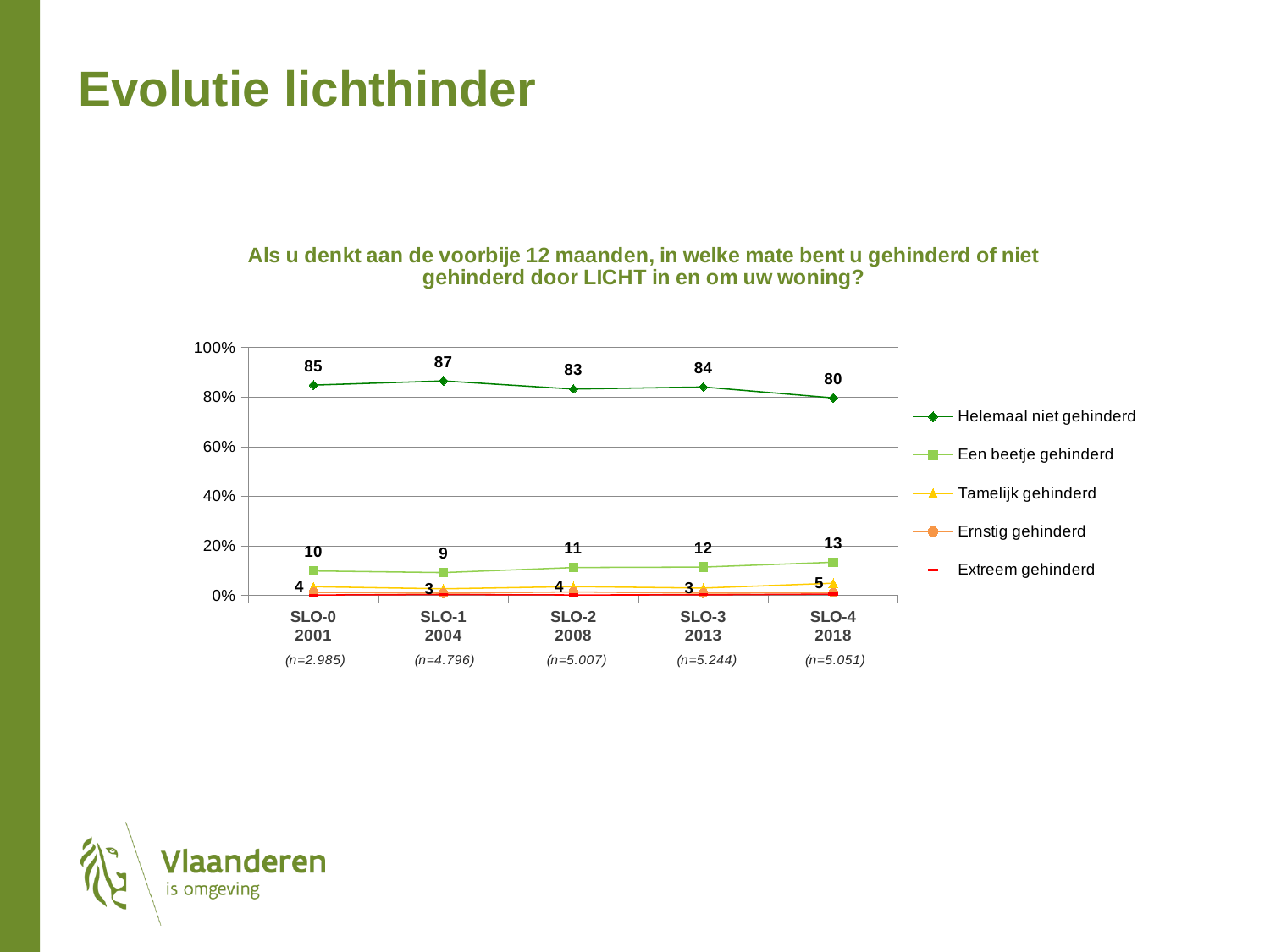
What kind of chart is shown on the slide? line chart How many series does the legend list? 5 In which survey wave is 'Helemaal niet gehinderd' at its lowest? SLO-4 2018 What is the value for 'Een beetje gehinderd' in SLO-4 2018? 13 Which legend entry is shown with a red line? Extreem gehinderd What is the difference between the 'Helemaal niet gehinderd' values for SLO-1 2004 and SLO-4 2018? 7 How many survey waves (categories) are plotted along the x axis? 5 What is the value for 'Helemaal niet gehinderd' in SLO-1 2004? 87 Which is larger: 'Een beetje gehinderd' in SLO-0 2001 or in SLO-3 2013? SLO-3 2013 Is the value for 'Helemaal niet gehinderd' in SLO-0 2001 greater or less than 80%? greater What is the value for 'Tamelijk gehinderd' in SLO-2 2008? 4 In which survey wave is 'Helemaal niet gehinderd' at its highest? SLO-1 2004